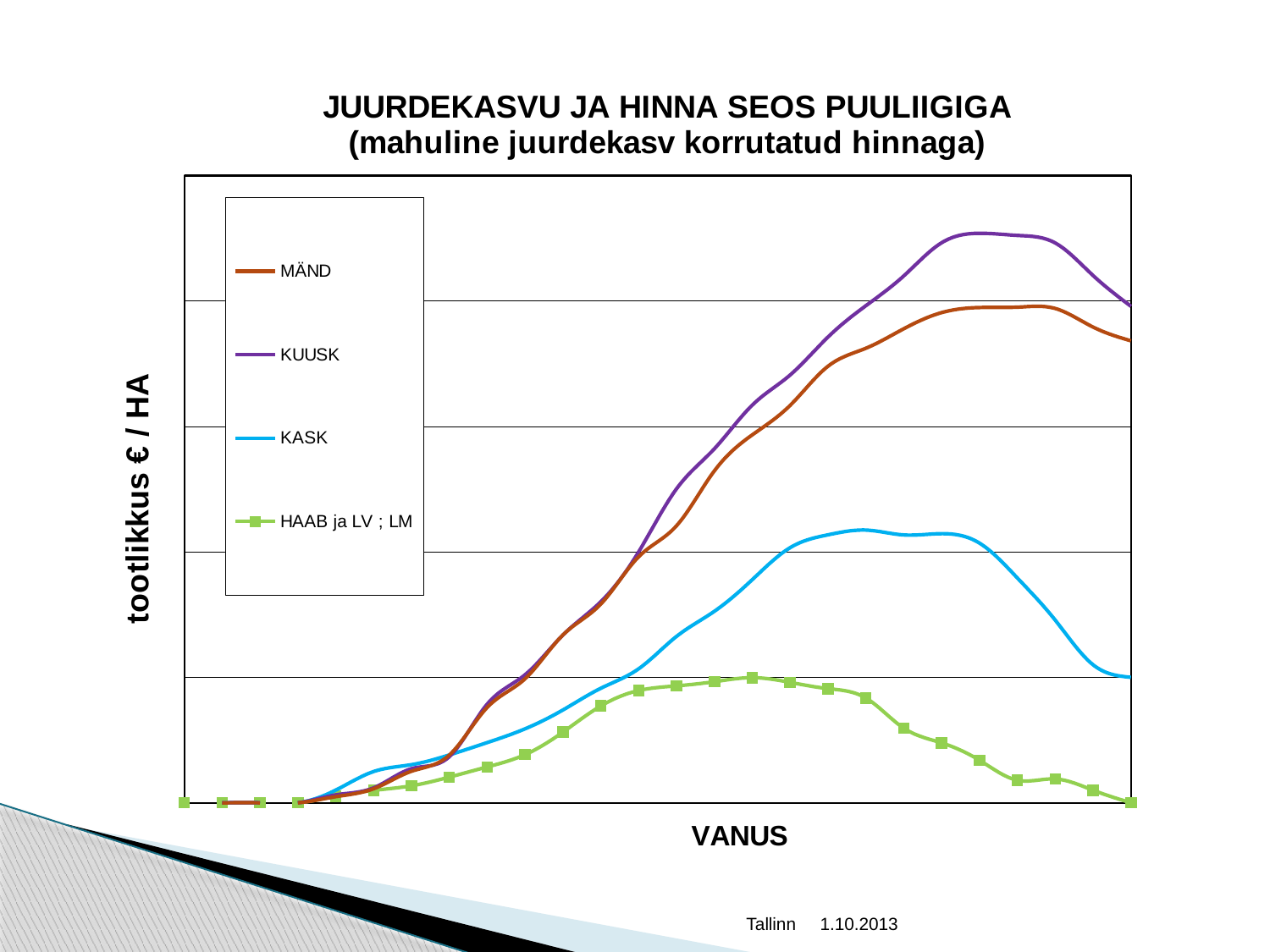
What kind of chart is shown on the slide? line chart At the right end of the x axis, which series is higher: MÄND or HAAB ja LV ; LM? MÄND Which series reaches the highest peak value on the chart? KUUSK At the right end of the x axis, which series is higher: KUUSK or KASK? KUUSK What is the title of the y axis? tootlikkus € / HA Which series has the lowest peak value on the chart? HAAB ja LV ; LM How many series does the legend list? 4 Which series has the second-highest peak value on the chart? MÄND Does the HAAB ja LV ; LM series rise steadily, fall steadily, or rise and then fall along the x axis? rise and then fall Does the KASK series rise and then fall, or rise steadily along the x axis? rise and then fall What is the title of the x axis? VANUS